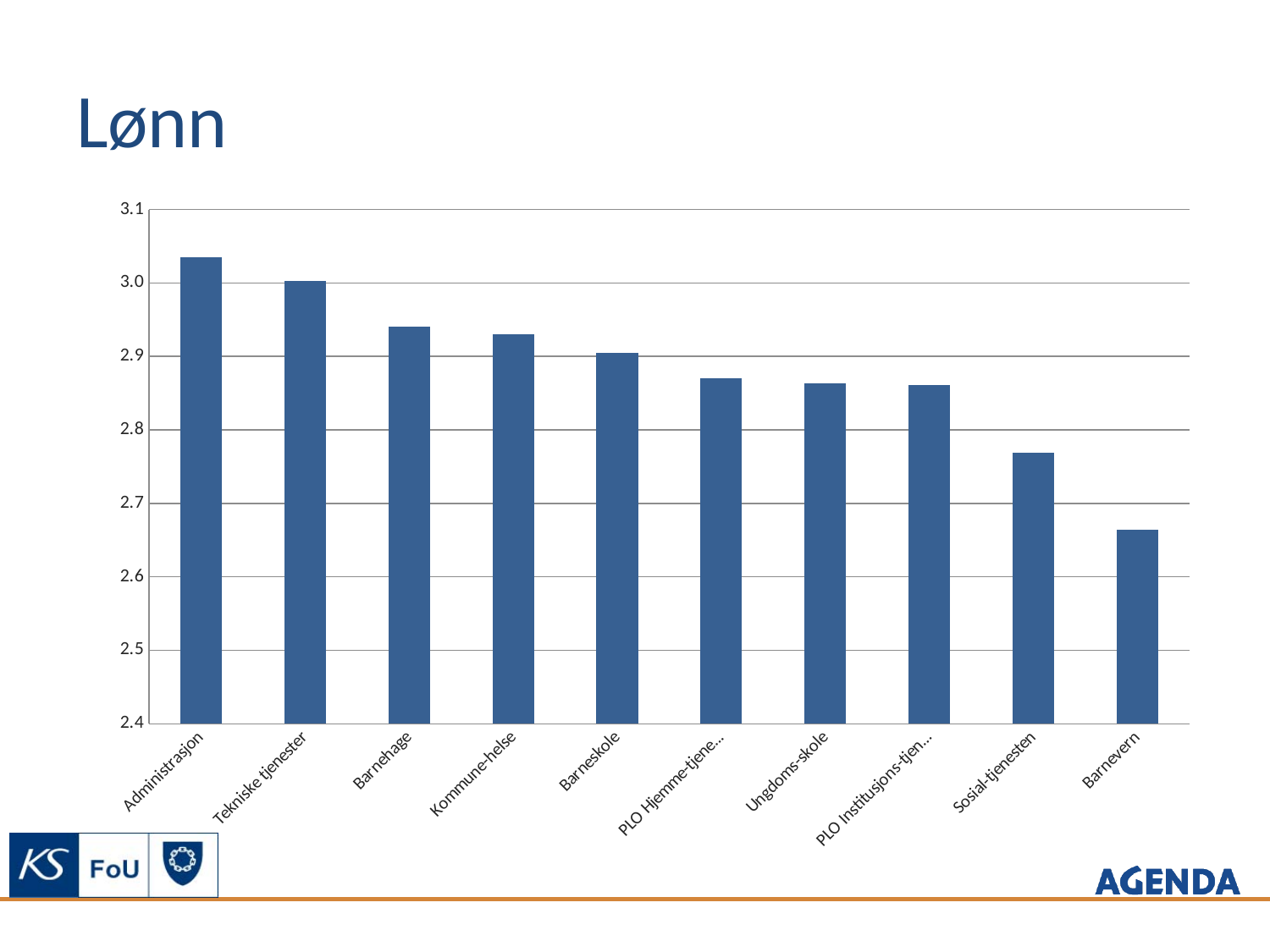
Is the value for Administrasjon greater or less than 3.0? greater Do the values rise or fall moving from left to right along the x axis? fall What kind of chart is shown on the slide? Bar chart What is the lowest value shown on the y axis of the chart? 2.4 Is the value for Barnevern greater or less than 2.7? less What is the title of the chart? Lønn Which category has the highest value in the chart? Administrasjon How many categories are shown on the x axis of the chart? 10 Is the value for Barnehage greater or less than 2.9? greater Which has a larger value, Barnehage or Sosial-tjenesten? Barnehage Which category has the lowest value in the chart? Barnevern